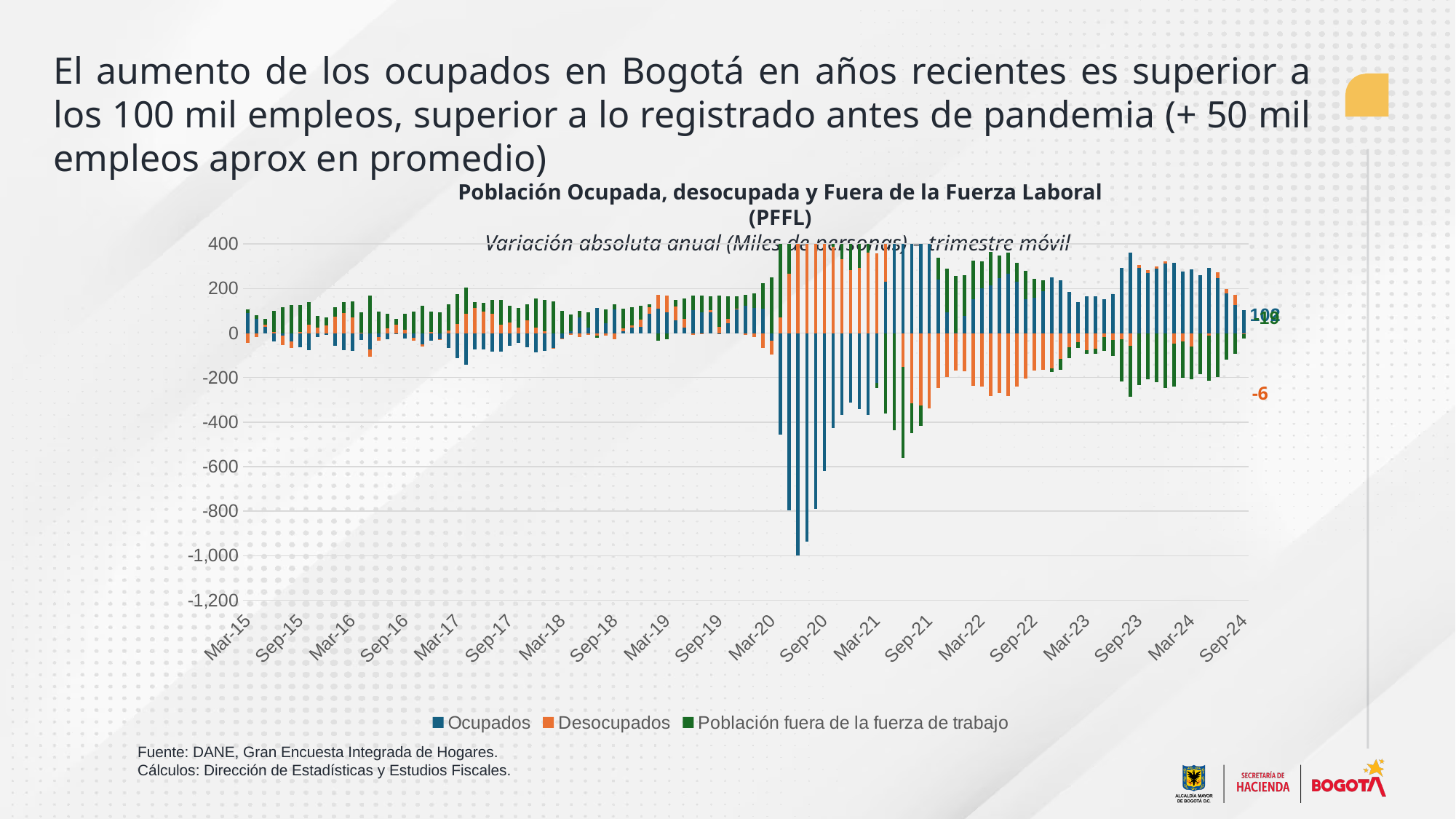
What is the last period shown on the horizontal axis? Sep-24 Is the value for Ocupados at Sep-24 greater or less than 0? greater Is the value for Población fuera de la fuerza de trabajo at Sep-23 greater or less than -200? less What is the lowest tick shown on the vertical axis? -1,200 Which series reaches the lowest value on the chart? Ocupados Which series is shown in blue in the legend? Ocupados Is the lowest value of Ocupados greater or less than -800? less What is the first period shown on the horizontal axis? Mar-15 Around Sep-20, which is larger: the value for Ocupados or the value for Desocupados? Desocupados How many series does the legend list? 3 What kind of chart is shown on the slide? Bar chart What is the title of the chart? Población Ocupada, desocupada y Fuera de la Fuerza Laboral (PFFL)